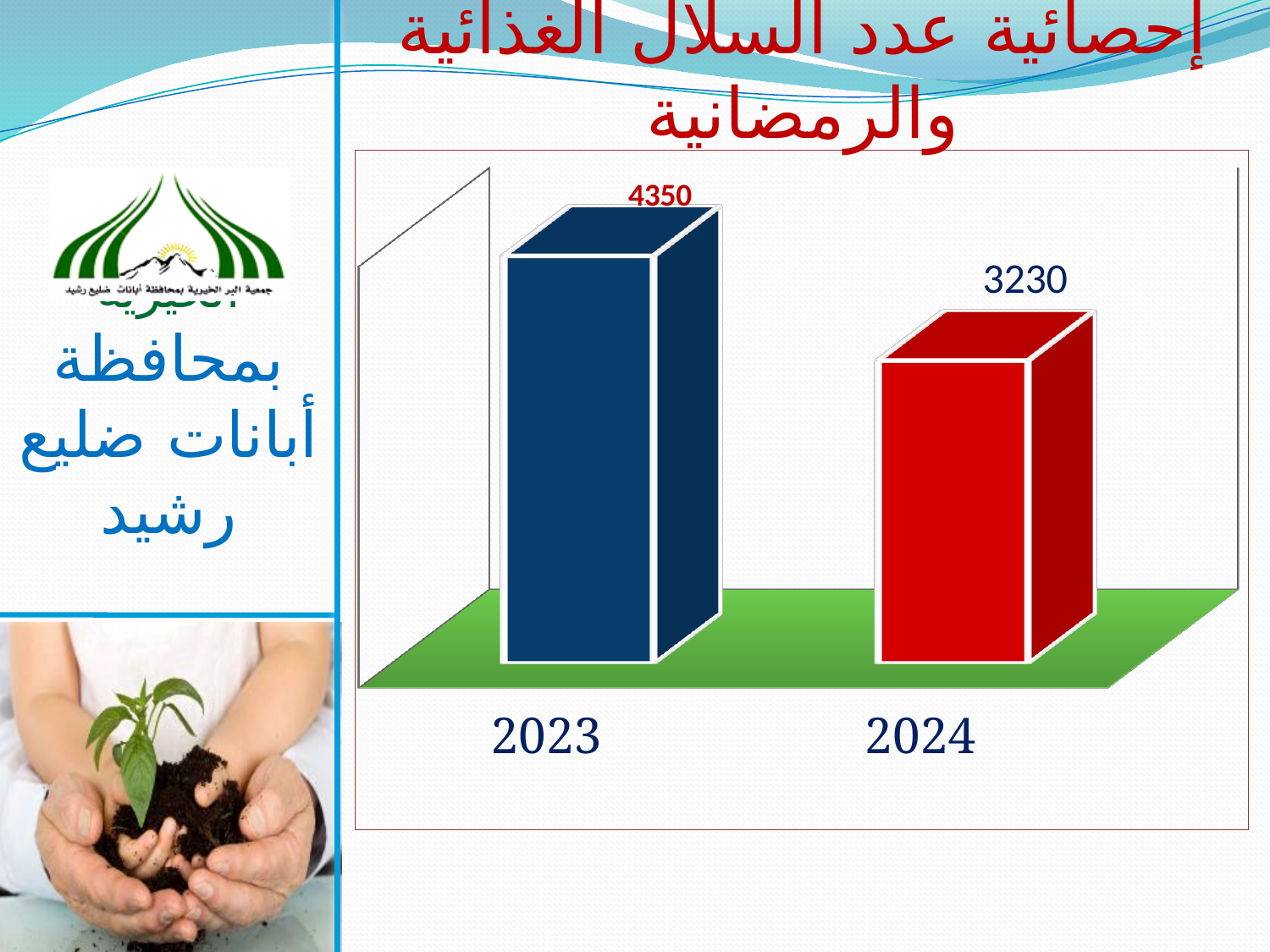
Which is larger, the value for 2023 or the value for 2024? 2023 What is the value for 2024? 3230 Do the values rise or fall from 2023 to 2024? fall Which year has the lowest value? 2024 What is the total of the values for 2023 and 2024? 7580 What colour is the bar for 2023? blue What is the value for 2023? 4350 What kind of chart is shown on the slide? bar chart Which year has the highest value? 2023 What colour is the bar for 2024? red What is the difference between the values for 2023 and 2024? 1120 How many categories are shown on the chart? 2